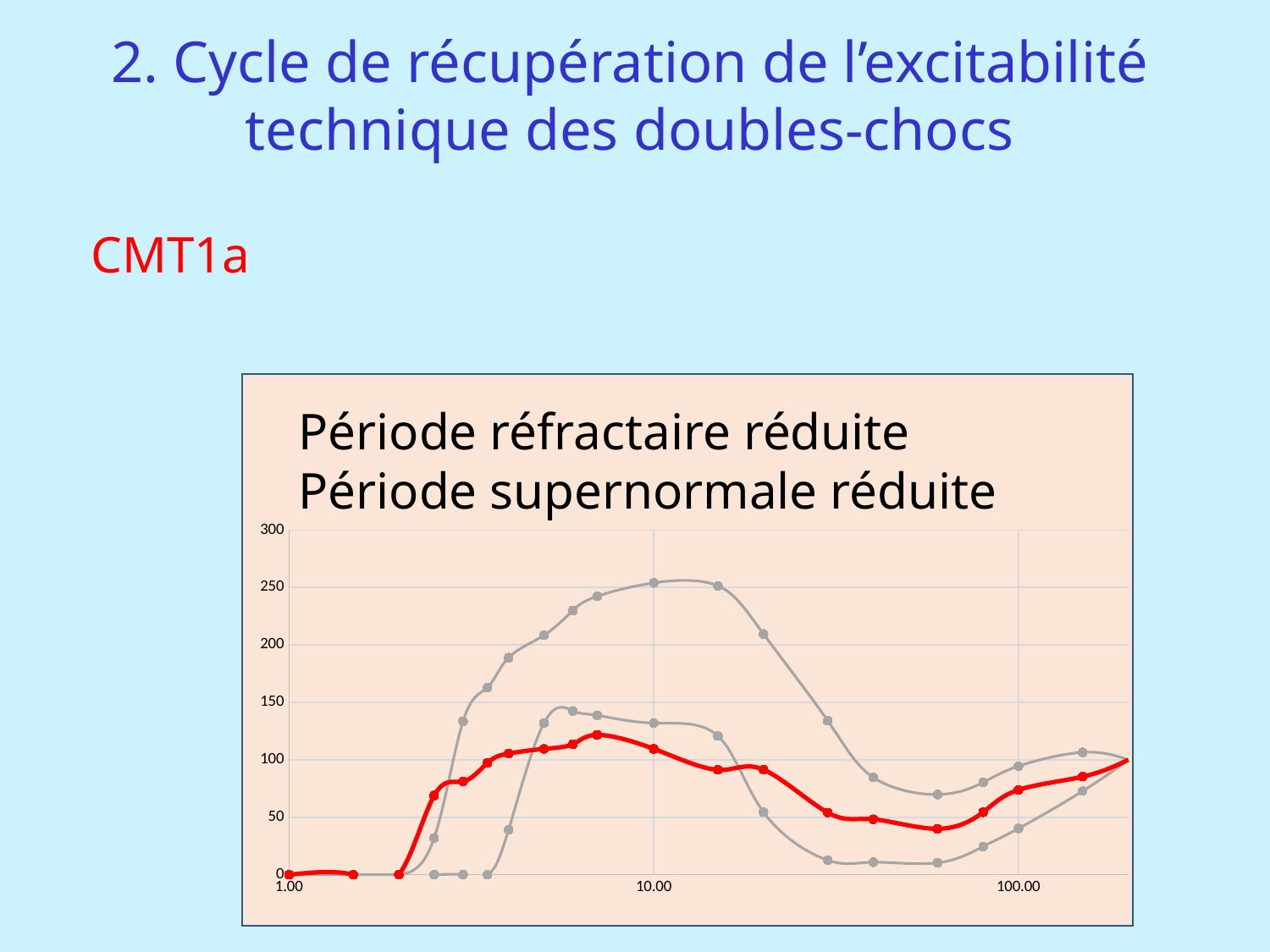
What is the highest value shown on the y axis? 300 Is the value of the lower grey line at x = 10.00 greater or less than 100? greater Does the red line rise or fall between x = 10.00 and x = 60? fall What is the value of the red line at x = 1.00? 0 Is the peak value of the upper grey line (near x = 10.00) greater or less than 200? greater What kind of chart is shown on the slide? line chart Is the value of the red line at x = 100.00 greater or less than 100? less At x = 10.00, which line is higher: the red line or the upper grey line? the upper grey line What text is written as the chart's title? Période réfractaire réduite Période supernormale réduite How many lines are plotted on the chart? 3